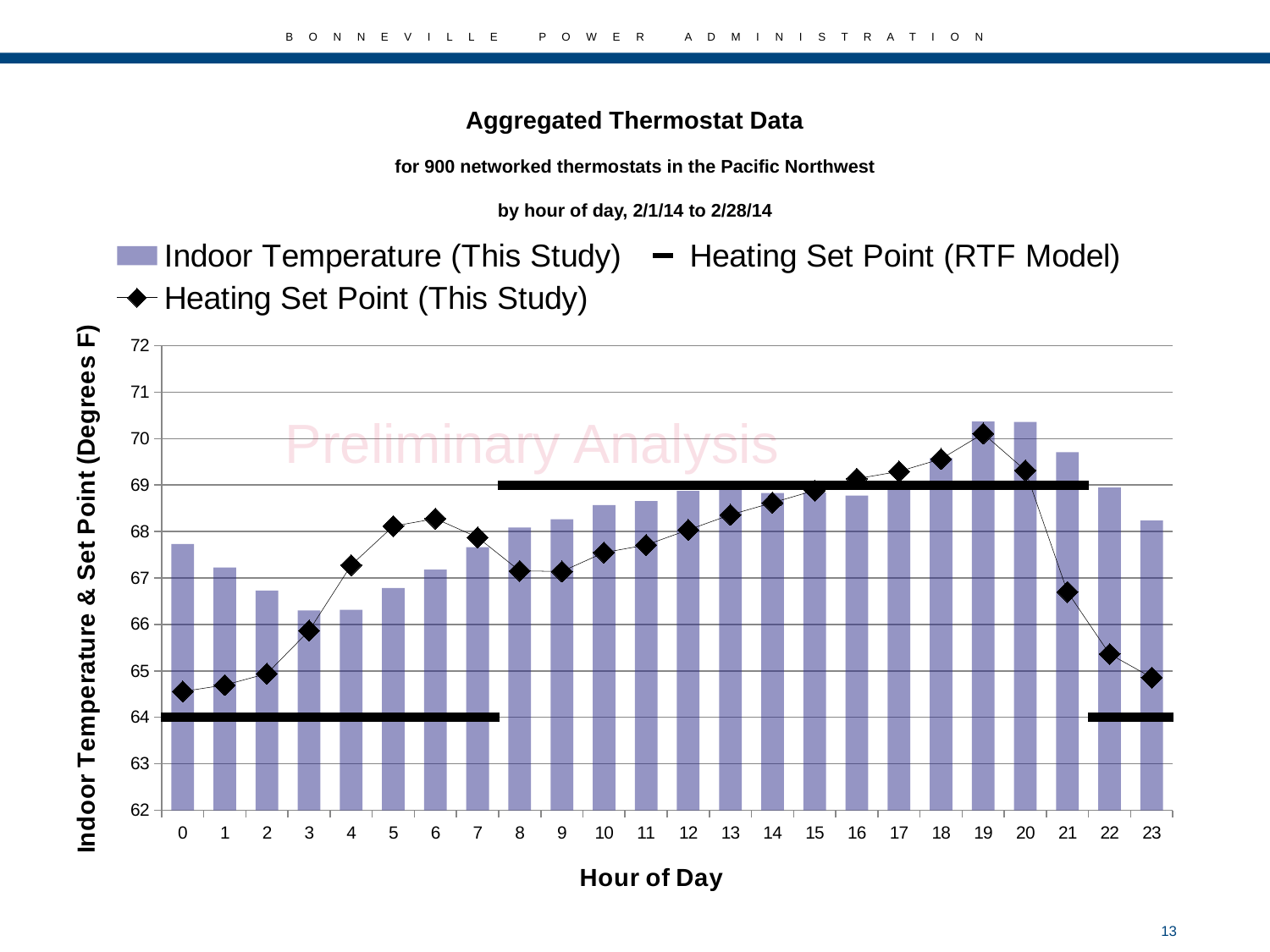
What is the Heating Set Point (RTF Model) value at hour 3? 64 Is the Indoor Temperature (This Study) at hour 3 greater or less than 67? less Which hour has the higher Indoor Temperature (This Study), hour 0 or hour 3? hour 0 Is the Indoor Temperature (This Study) at hour 0 greater or less than 67? greater How many series does the legend list? 3 What kind of chart is used to plot the Indoor Temperature (This Study) series? bar chart How many hours of the day are shown on the x axis? 24 At which hour of day is the Heating Set Point (This Study) highest? 19 What is the label of the x axis? Hour of Day What is the Heating Set Point (RTF Model) value at hour 12? 69 Is the Heating Set Point (This Study) at hour 1 greater or less than 65? less Does the Heating Set Point (This Study) rise or fall from hour 20 to hour 23? fall